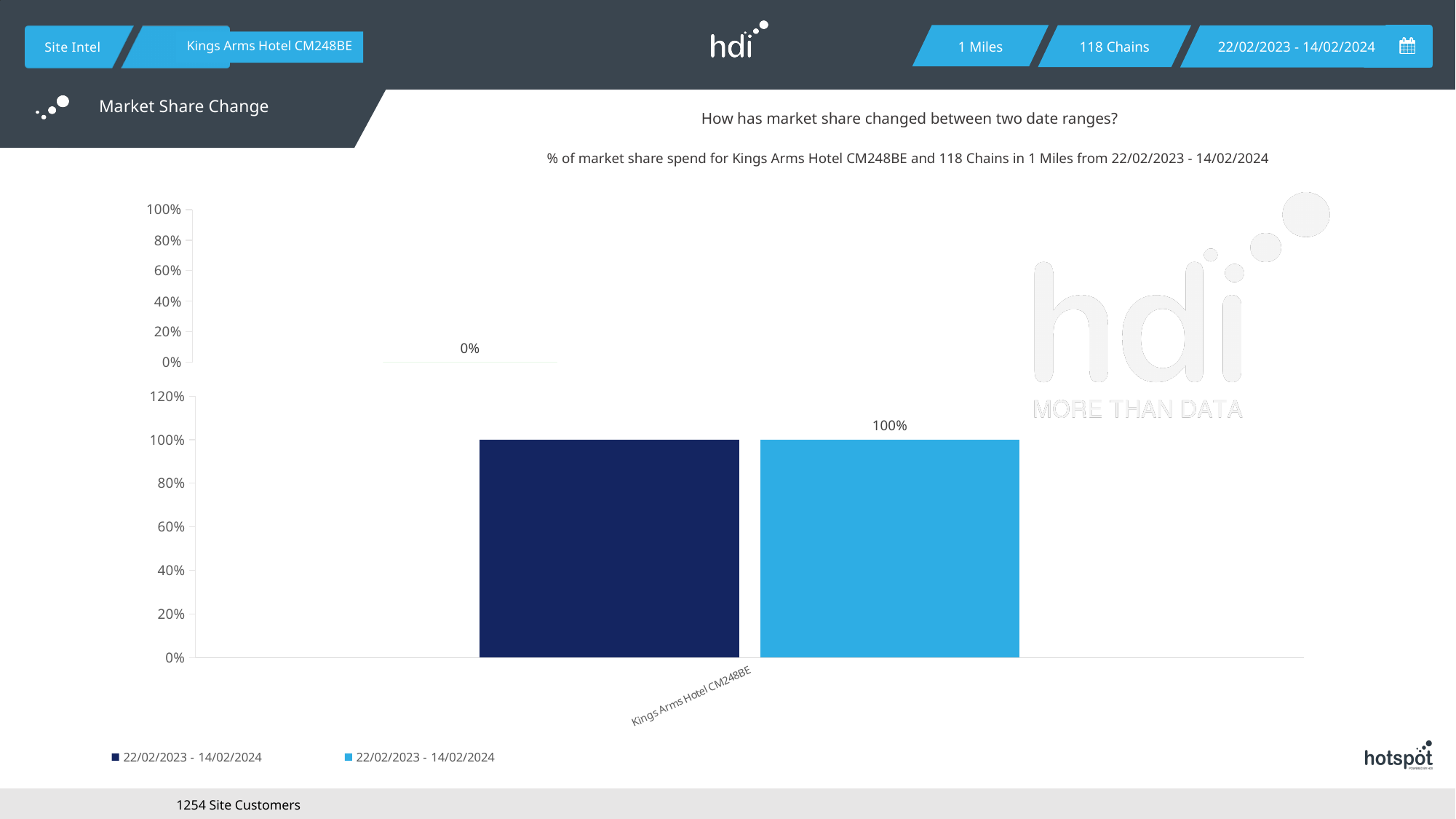
In the bottom chart, how many series does the legend list? 2 In the bottom chart, what value does the dark blue bar for Kings Arms Hotel CM248BE reach on the y axis? 100% In the bottom chart, how many categories are shown on the x axis? 1 In the top chart, is the labelled value greater or less than 20%? less In the bottom chart, is the value of the dark blue bar greater or less than 80%? greater In the bottom chart, what value is labelled on the light blue bar for Kings Arms Hotel CM248BE? 100% In the bottom chart, what is the difference between the light blue bar and the dark blue bar for Kings Arms Hotel CM248BE? 0% In the bottom chart, what date range is shown for the legend entries? 22/02/2023 - 14/02/2024 In the top chart, what value is shown by the data label? 0% What kind of chart is the bottom chart on the slide? bar chart In the bottom chart, what is the category label shown on the x axis? Kings Arms Hotel CM248BE